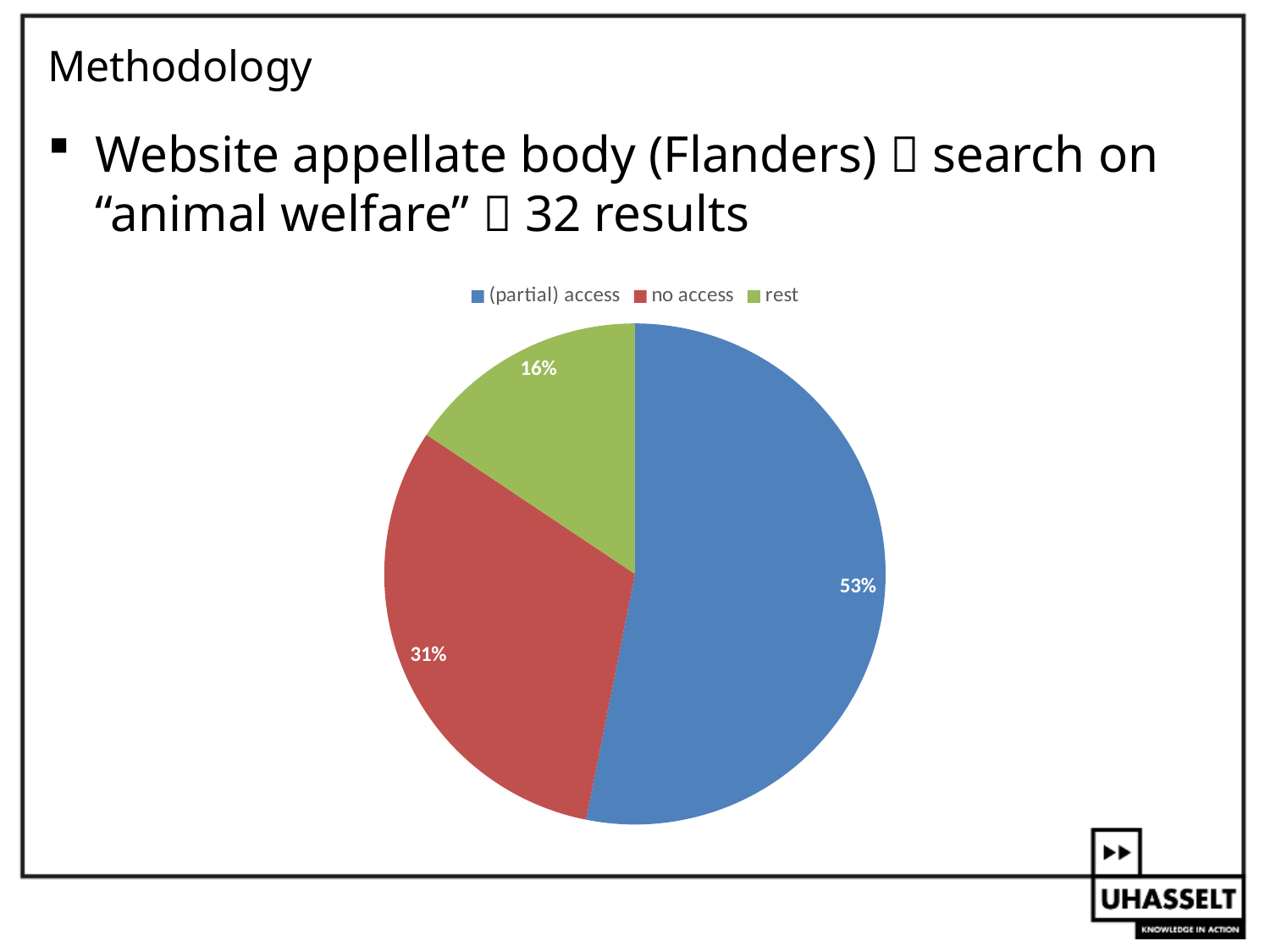
What kind of chart is shown on the slide? pie chart How many categories are shown in the pie chart? 3 What share of the pie does the "no access" slice represent? 31% What is the difference in percentage points between the "(partial) access" and "no access" slices? 22 What share of the pie does the "rest" slice represent? 16% What colour is the "no access" slice in the pie chart? red Which slice is larger, "no access" or "rest"? no access What is the difference in percentage points between the "no access" and "rest" slices? 15 What share of the pie does the "(partial) access" slice represent? 53% Which category has the largest slice of the pie? (partial) access Which category is shown in green in the pie chart? rest Which category has the smallest slice of the pie? rest